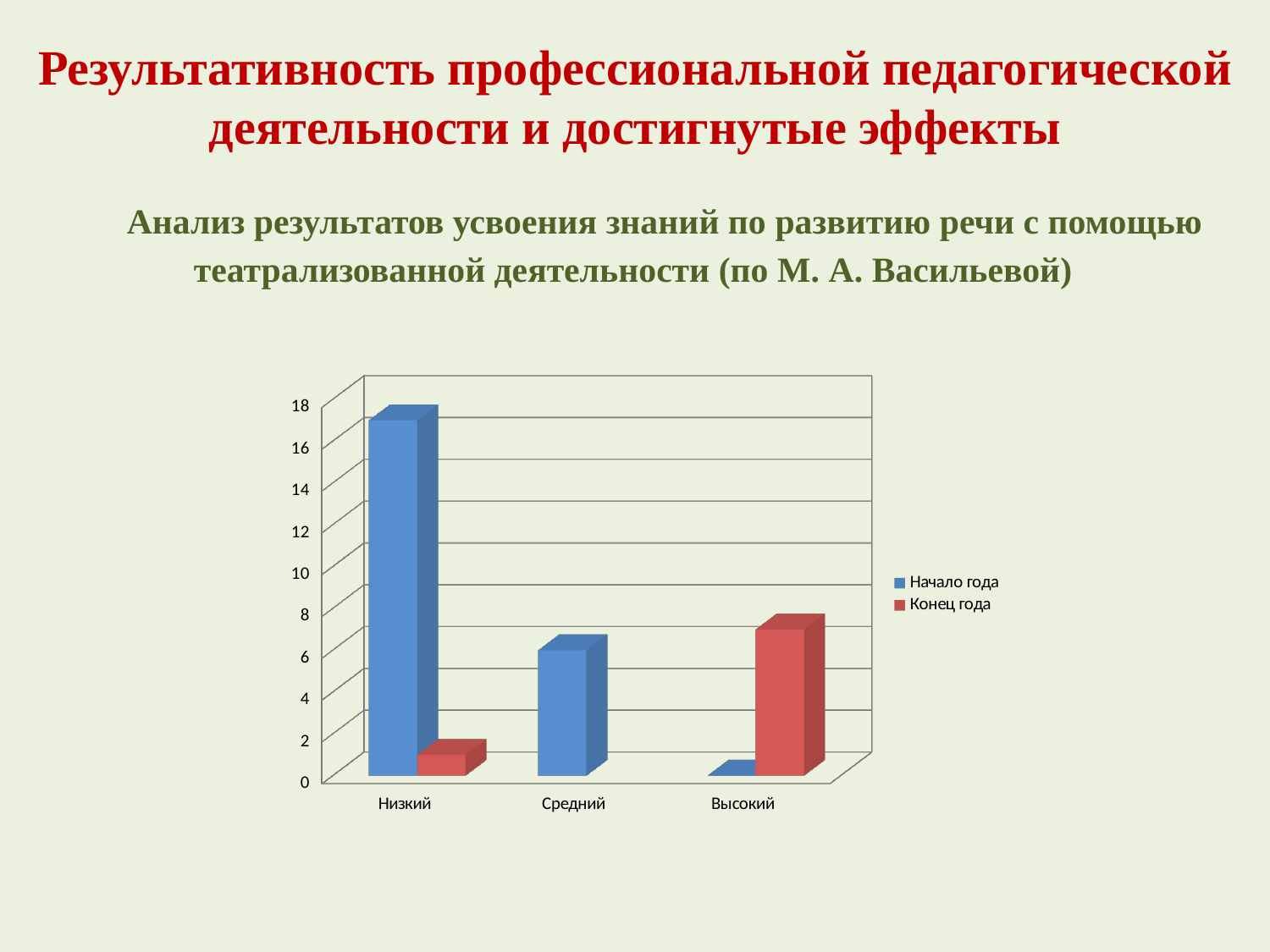
Which category has the highest value for the series Начало года? Низкий Do the values for the series Начало года rise or fall from Низкий to Высокий along the x axis? fall Is the value for Средний in the series Начало года greater or less than 8? less Which category has the highest value for the series Конец года? Высокий For the category Высокий, which series has the larger value: Начало года or Конец года? Конец года Is the value for Низкий in the series Начало года greater or less than 14? greater How many series does the chart legend list? 2 For the category Низкий, which series has the larger value: Начало года or Конец года? Начало года Which colour represents the series Конец года in the chart legend? red What kind of chart is shown on the slide? bar chart Which category has the lowest value for the series Начало года? Высокий How many categories are shown on the x axis of the chart? 3